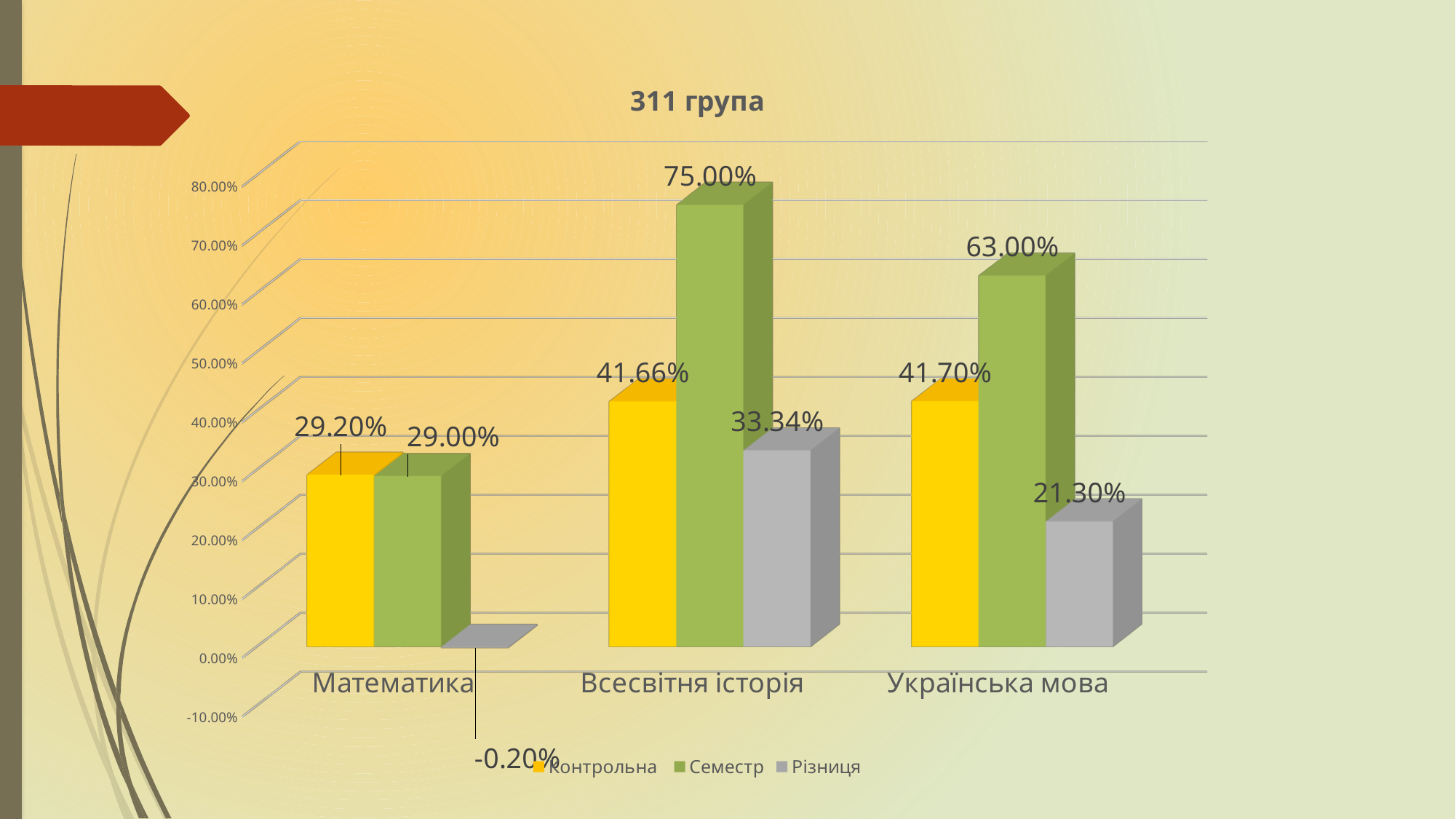
Which category has the lowest Різниця value? Математика What is the Контрольна value for Математика? 29.20% What is the title of the chart? 311 група What is the Семестр value for Всесвітня історія? 75.00% Which is larger for Всесвітня історія: the Контрольна value or the Семестр value? Семестр What is the Різниця value for Математика? -0.20% How many categories are shown on the x axis? 3 What is the Різниця value for Українська мова? 21.30% What is the difference between the Семестр and Контрольна values for Українська мова? 21.30% How many series does the legend list? 3 Which category has the highest Семестр value? Всесвітня історія What type of chart is shown on the slide? bar chart